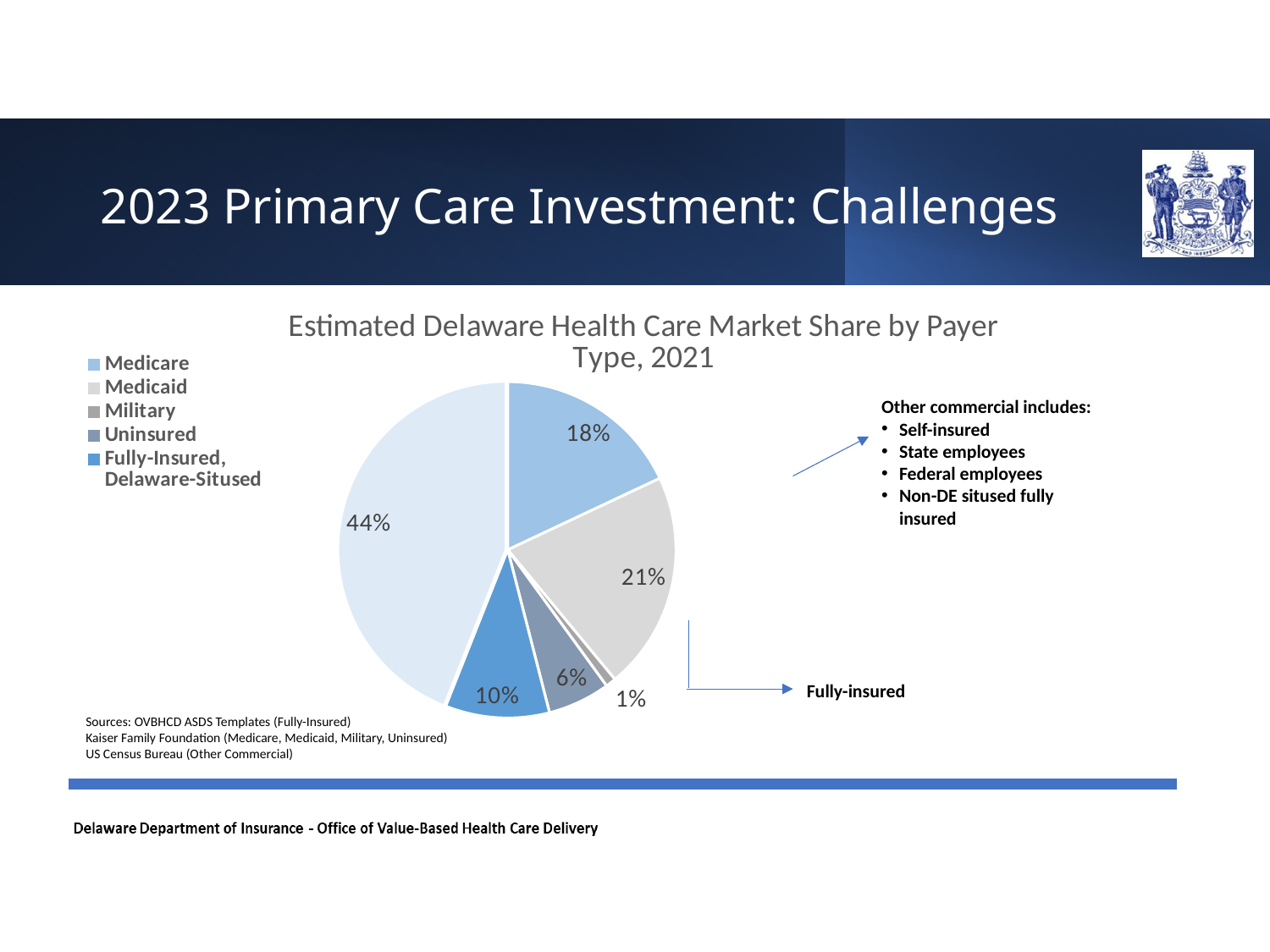
What is the title of the chart? Estimated Delaware Health Care Market Share by Payer Type, 2021 What share of the market is attributed to Medicaid? 21% Which slice of the pie is the smallest? Military What type of chart is shown on the slide? Pie chart What share of the market is attributed to Fully-Insured, Delaware-Sitused? 10% What share of the market is attributed to Uninsured? 6% What share of the Delaware health care market is attributed to Medicare? 18% How many entries does the chart legend list? 5 How many percentage points larger is the Medicaid share than the Medicare share? 3 What share of the market is attributed to Military? 1% Which is larger, the Medicaid share or the Medicare share? Medicaid What share of the market is attributed to the Other commercial slice? 44%